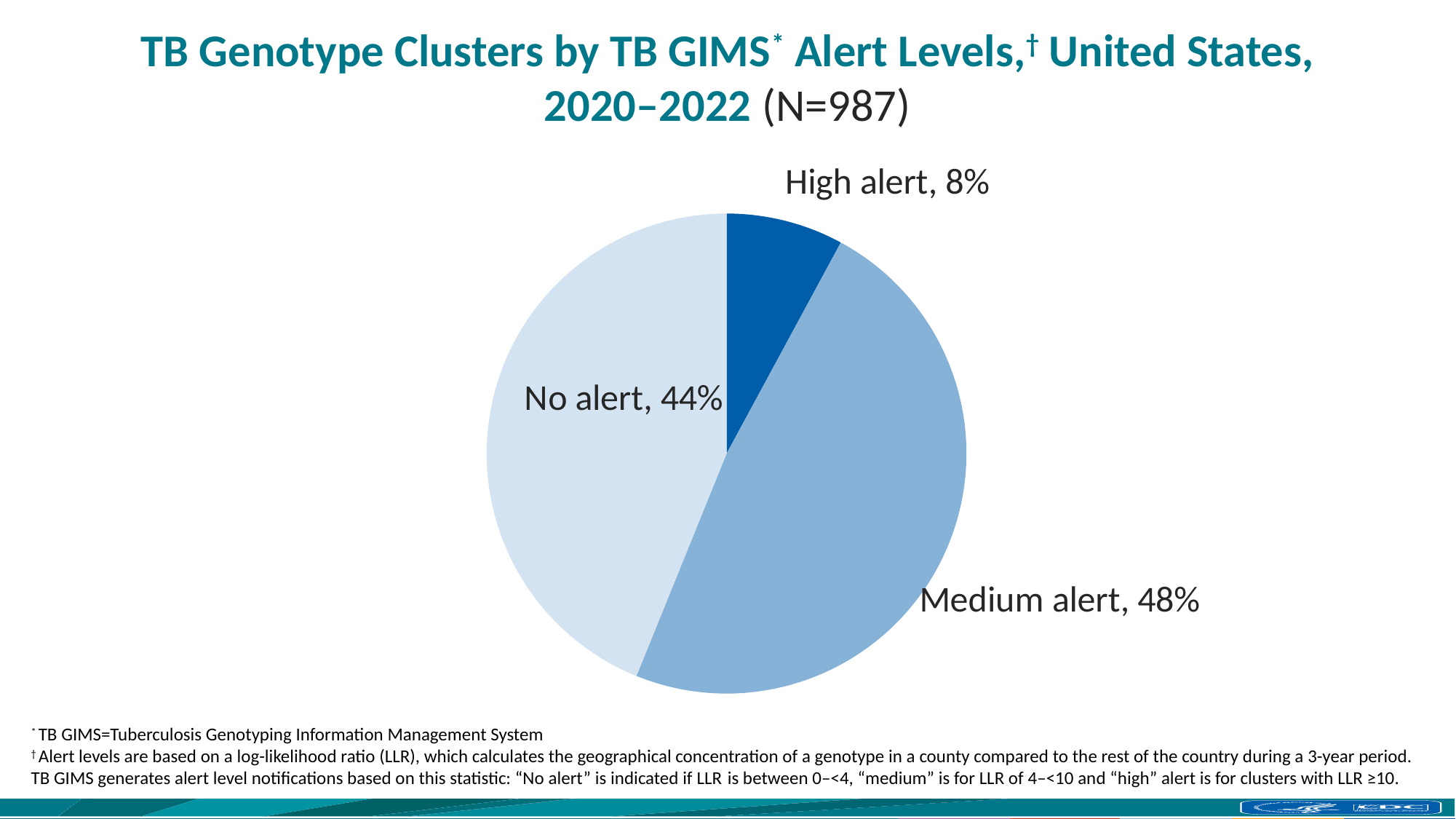
What is the total number of TB genotype clusters (N) given in the chart title? 987 What percentage of TB genotype clusters had a high alert level? 8% What kind of chart is shown on the slide? Pie chart Which alert level accounts for the largest share of the pie? Medium alert What is the difference in percentage points between the medium alert and no alert slices? 4 Which is larger, the share for no alert or the share for high alert? No alert How many alert level categories are shown in the pie chart? 3 What time period does the chart cover? 2020–2022 What is the difference in percentage points between the no alert and high alert slices? 36 Which alert level accounts for the smallest share of the pie? High alert What percentage of TB genotype clusters had a medium alert level? 48% What percentage of TB genotype clusters had no alert? 44%